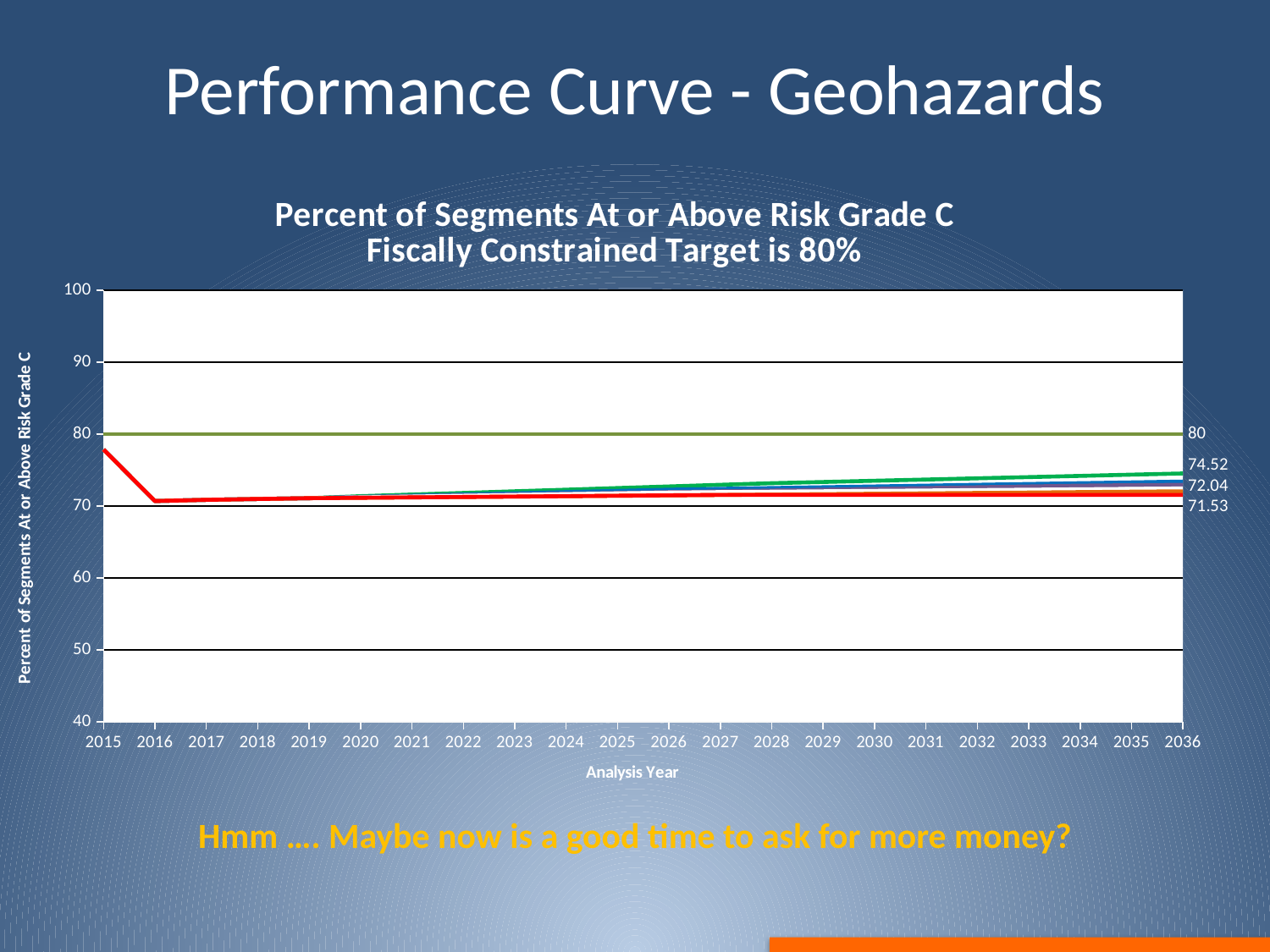
What value does the red line reach in 2036, as labelled at the right edge of the chart? 71.53 From 2016 to 2036, does the red line rise or fall? rise How many years are shown on the x axis of the chart? 22 What kind of chart is shown on the slide? line chart What is the title of the x axis of the chart? Analysis Year What value does the green line reach in 2036, as labelled at the right edge of the chart? 74.52 Is the value of the red line in 2015 greater or less than 80? less In 2036, which line is higher, the green line or the blue line? the green line What is the value of the flat horizontal target line labelled at the right edge of the chart? 80 What is the difference between the 80 target line and the green line's 2036 value of 74.52? 5.48